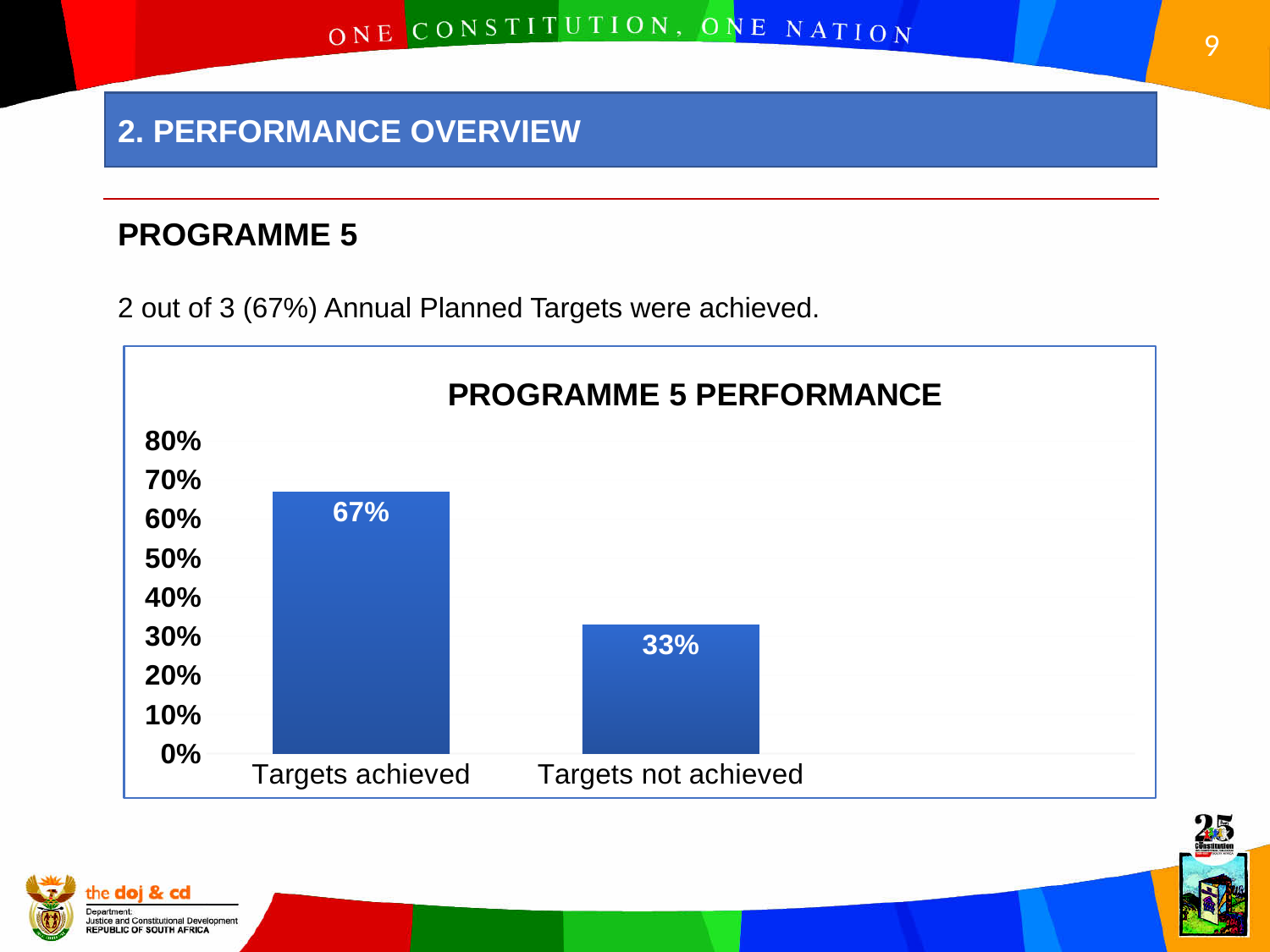
What is the difference between the values for Targets achieved and Targets not achieved? 34% How many categories are shown on the chart? 2 What is the value for Targets not achieved? 33% Is the value for Targets achieved greater or less than 60%? greater Which category has the lowest value? Targets not achieved What is the title of the chart? PROGRAMME 5 PERFORMANCE What kind of chart is shown on the slide? bar chart What is the value for Targets achieved? 67% What is the highest value shown on the vertical axis? 80% Which category has the highest value? Targets achieved Which is larger, the value for Targets achieved or the value for Targets not achieved? Targets achieved Is the value for Targets not achieved greater or less than 40%? less